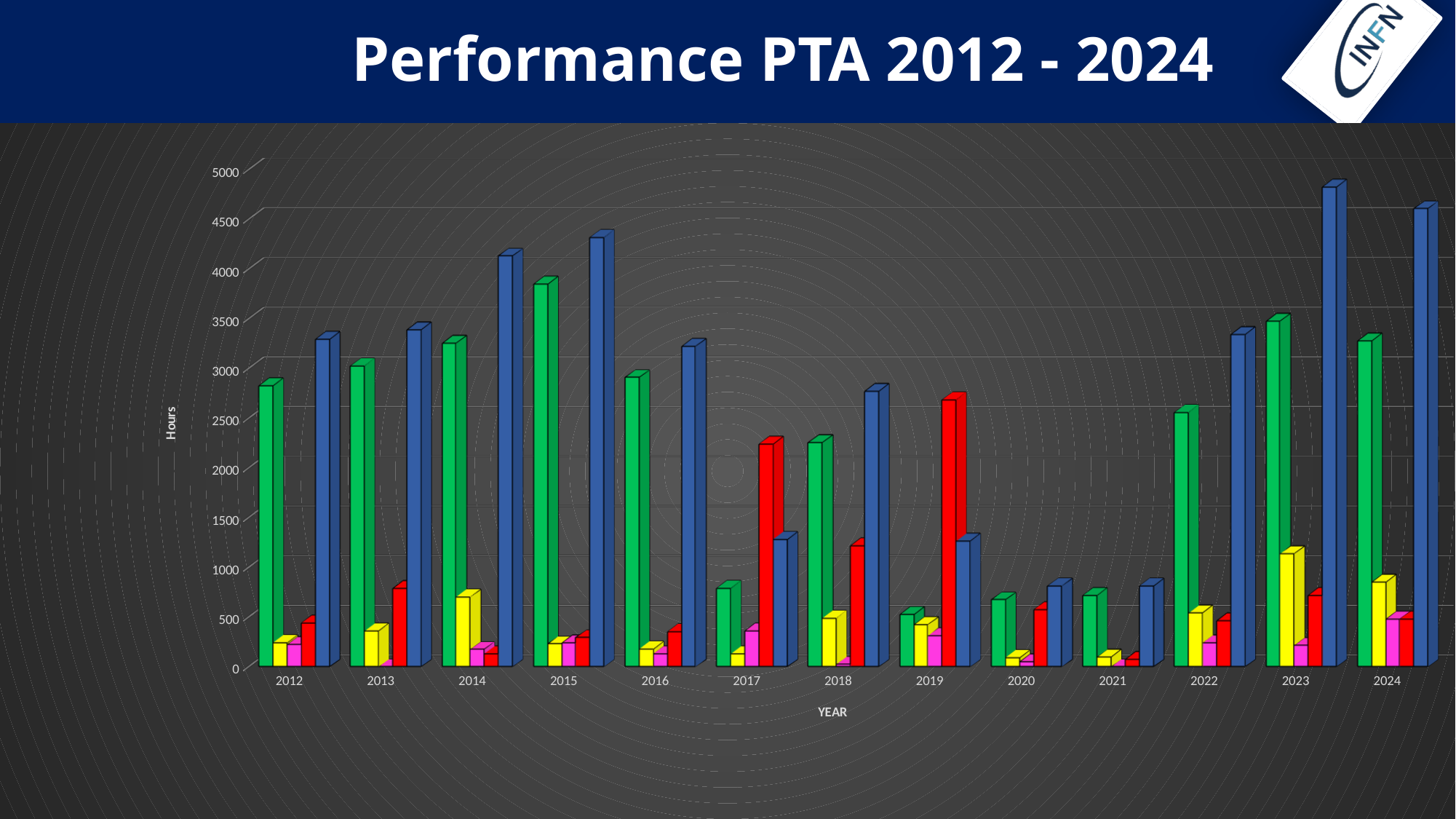
For 2012, which is larger: the green bar or the blue bar? the blue bar Is the value of the green bar for 2017 greater or less than 1000? less How many years are shown along the x axis of the chart? 13 What is the title of the chart on the slide? Performance PTA 2012 - 2024 Is the value of the green bar for 2015 greater or less than 3500? greater What is the label of the vertical axis of the chart? Hours In which year is the green bar the shortest? 2019 In which year is the blue bar the tallest? 2023 Is the value of the red bar for 2019 greater or less than 2500? greater What kind of chart is shown on the slide? bar chart